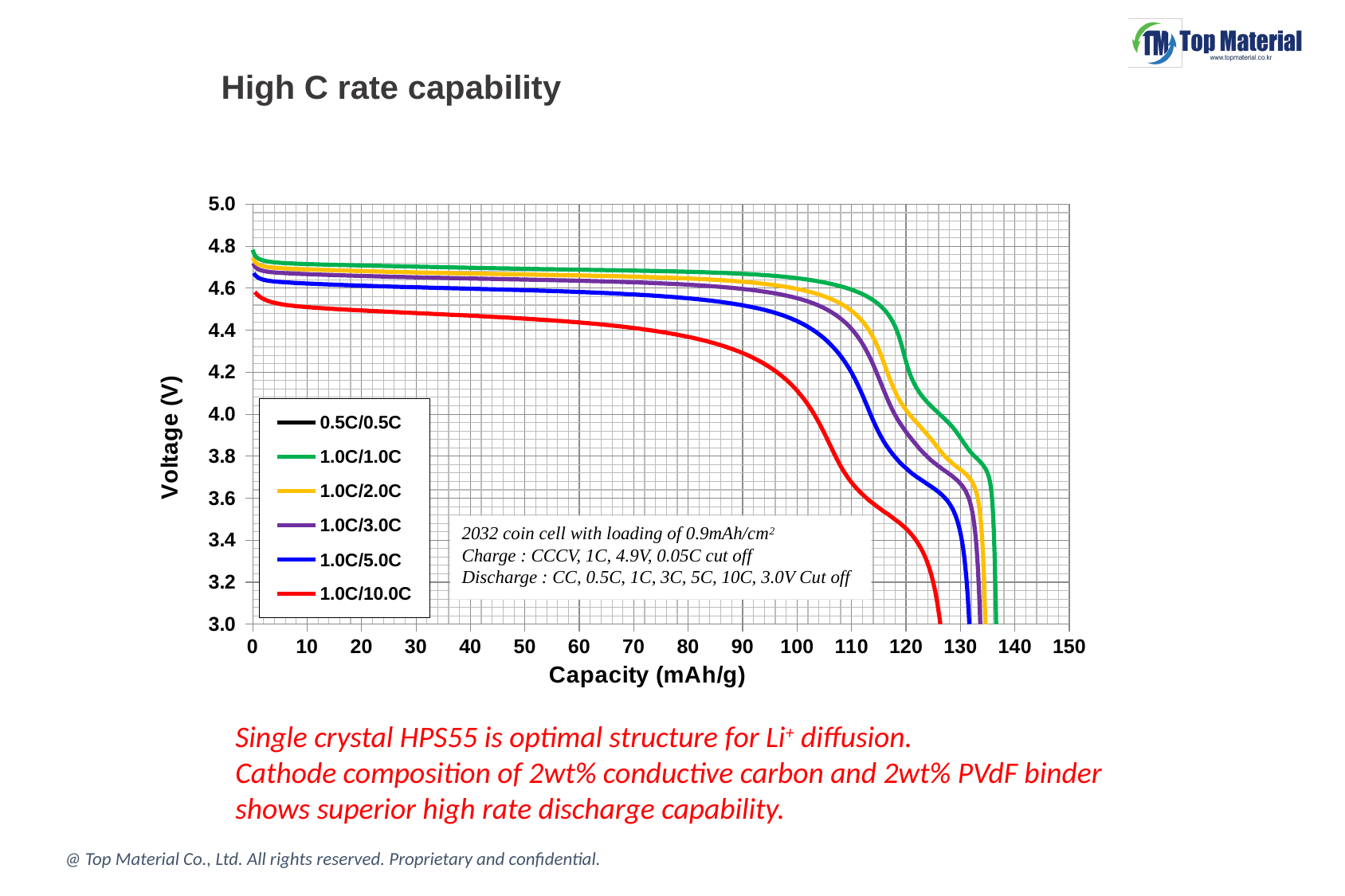
What is the title of the slide's chart? High C rate capability Is the voltage of the 1.0C/1.0C curve at a capacity of 100 mAh/g greater or less than 4.4 V? greater Among the visible curves, which series has the lowest voltage at a capacity of 50 mAh/g? 1.0C/10.0C What is the label of the chart's x axis? Capacity (mAh/g) Is the capacity at which the 1.0C/1.0C curve reaches 3.0 V greater or less than 130 mAh/g? greater Is the capacity at which the 1.0C/10.0C curve reaches 3.0 V greater or less than 130 mAh/g? less Which curve reaches the 3.0 V cut-off at a larger capacity, 1.0C/5.0C or 1.0C/10.0C? 1.0C/5.0C Does the voltage rise or fall as capacity increases along the x axis? fall Which curve reaches the 3.0 V cut-off at a larger capacity, 1.0C/1.0C or 1.0C/10.0C? 1.0C/1.0C What kind of chart is shown on the slide? line chart How many series does the chart legend list? 6